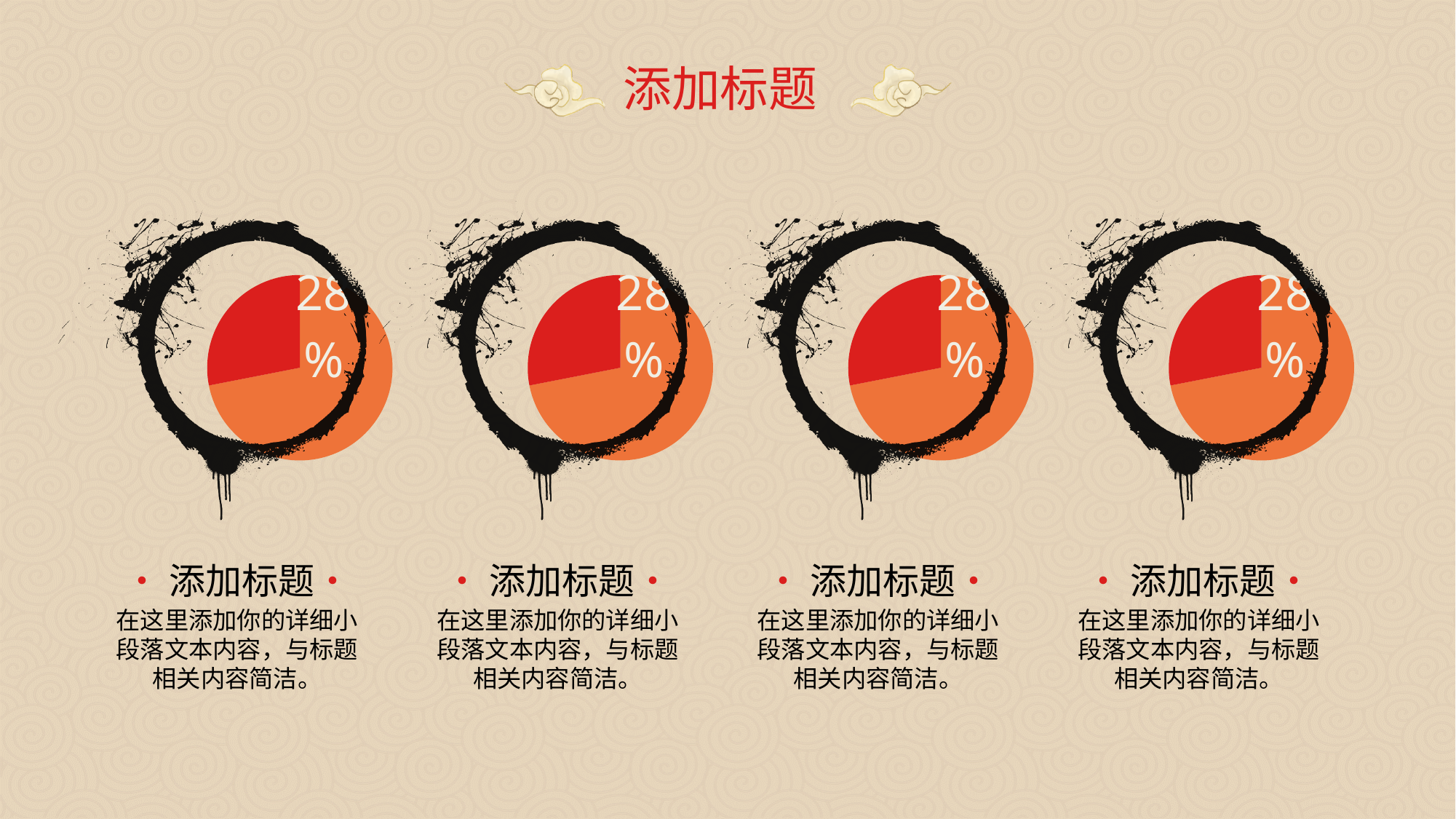
In the second pie chart from the left, what value is labelled on the red slice? 28% What colour is the slice that carries the 28% label in the second pie chart from the left? red What kind of chart is shown in the leftmost ink circle? pie chart How many slices does each pie chart on the slide have? 2 What is the title printed at the top of the slide? 添加标题 In the leftmost pie chart, which slice is larger, the red slice or the orange slice? the orange slice In the rightmost pie chart, is the red slice's share greater or less than 50%? less Do all four pie charts on the slide show the same labelled value for the red slice? yes In the rightmost pie chart, what percentage is shown on the red slice? 28% In the leftmost pie chart, what percentage is printed on the red slice? 28% How many pie charts are on the slide? 4 In the third pie chart from the left, what share of the pie does the red slice represent? 28%